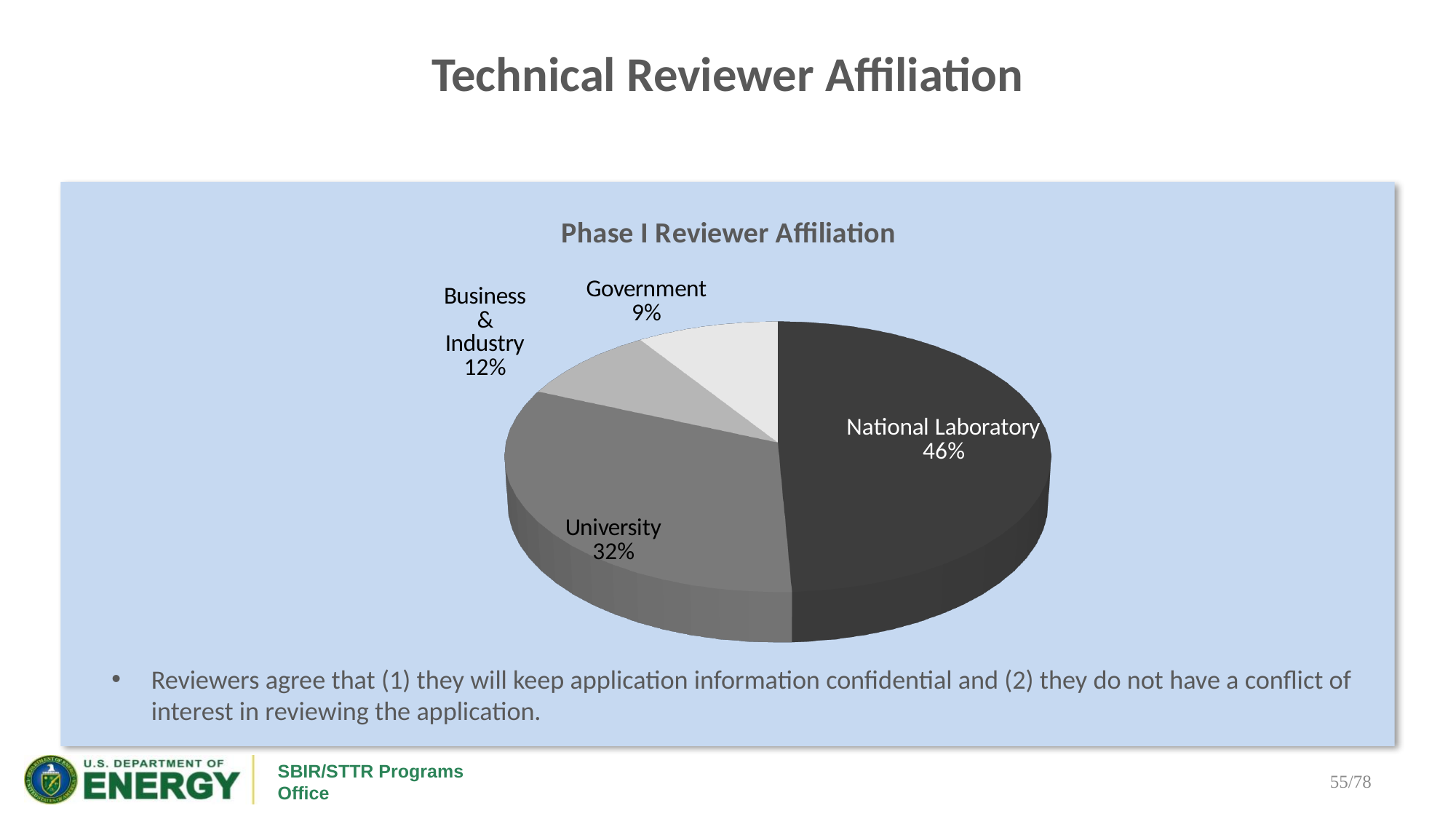
How many percentage points larger is the National Laboratory share than the University share? 14 Which affiliation has the largest share of Phase I reviewers? National Laboratory What share of Phase I reviewers are affiliated with a National Laboratory? 46% Which is larger, the University share or the Business & Industry share? University What is the difference in percentage points between Business & Industry and Government? 3 Which affiliation has the smallest share of Phase I reviewers? Government What type of chart is shown on the slide? Pie chart What percentage of Phase I reviewers come from a University? 32% How many affiliation categories are shown in the pie chart? 4 What is the title of the chart? Phase I Reviewer Affiliation What share of the pie is Business & Industry? 12% What percentage of Phase I reviewers are from Government? 9%